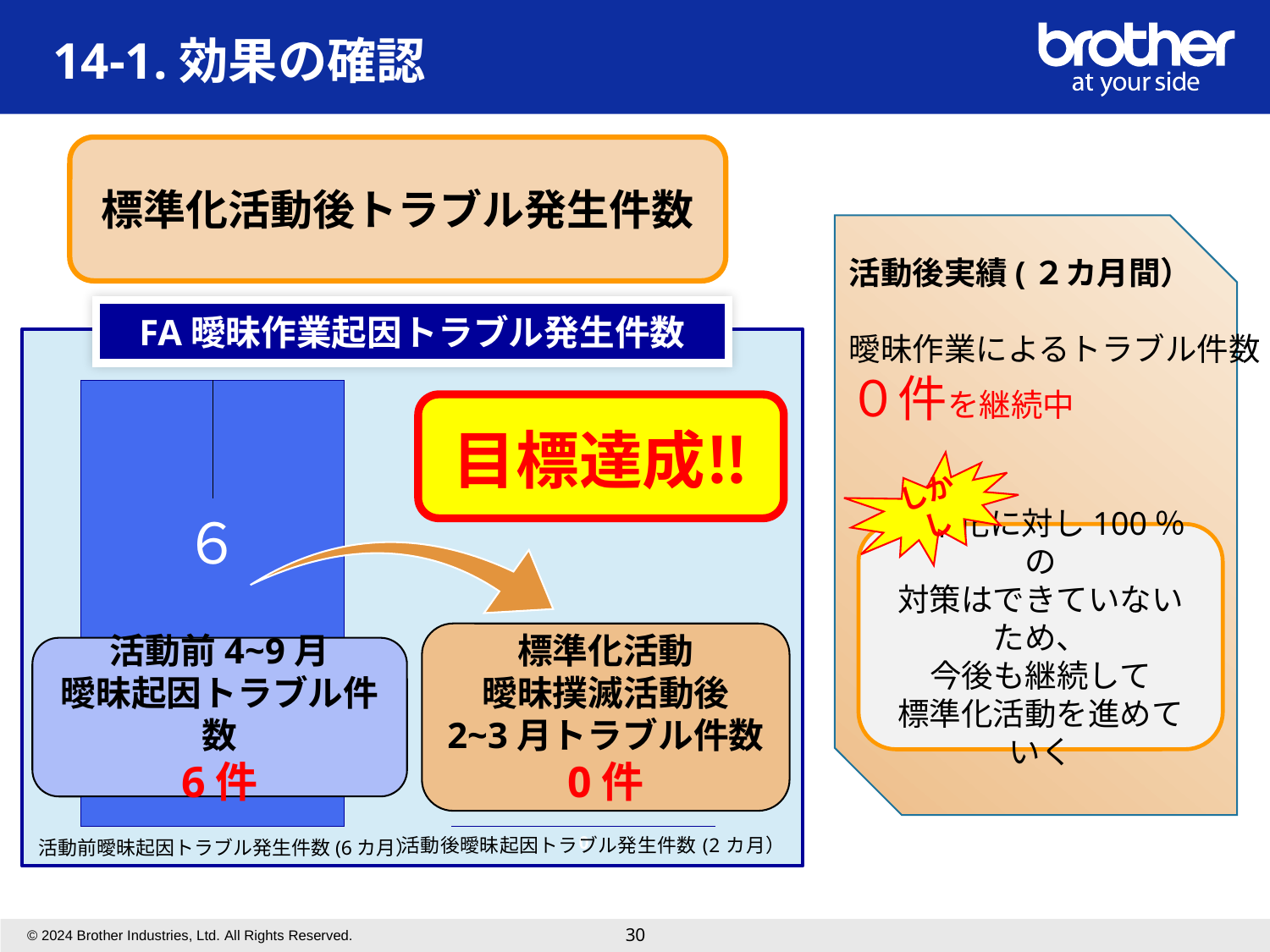
What is the value for 活動後曖昧起因トラブル発生件数(2カ月) in the chart? 0 Which category has the lowest value in the chart? 活動後曖昧起因トラブル発生件数(2カ月) Which is larger: the value for 活動前曖昧起因トラブル発生件数(6カ月) or the value for 活動後曖昧起因トラブル発生件数(2カ月)? 活動前曖昧起因トラブル発生件数(6カ月) What is the title of the chart on the slide? FA曖昧作業起因トラブル発生件数 How many categories does the chart show? 2 What type of chart is shown on the slide? bar chart What is the difference between the value for 活動前曖昧起因トラブル発生件数(6カ月) and the value for 活動後曖昧起因トラブル発生件数(2カ月)? 6 What is the value for 活動前曖昧起因トラブル発生件数(6カ月) in the chart? 6 What colour is the bar for 活動前曖昧起因トラブル発生件数(6カ月) in the chart? blue Which category has the highest value in the chart? 活動前曖昧起因トラブル発生件数(6カ月) Do the values in the chart rise or fall from left to right along the x axis? fall